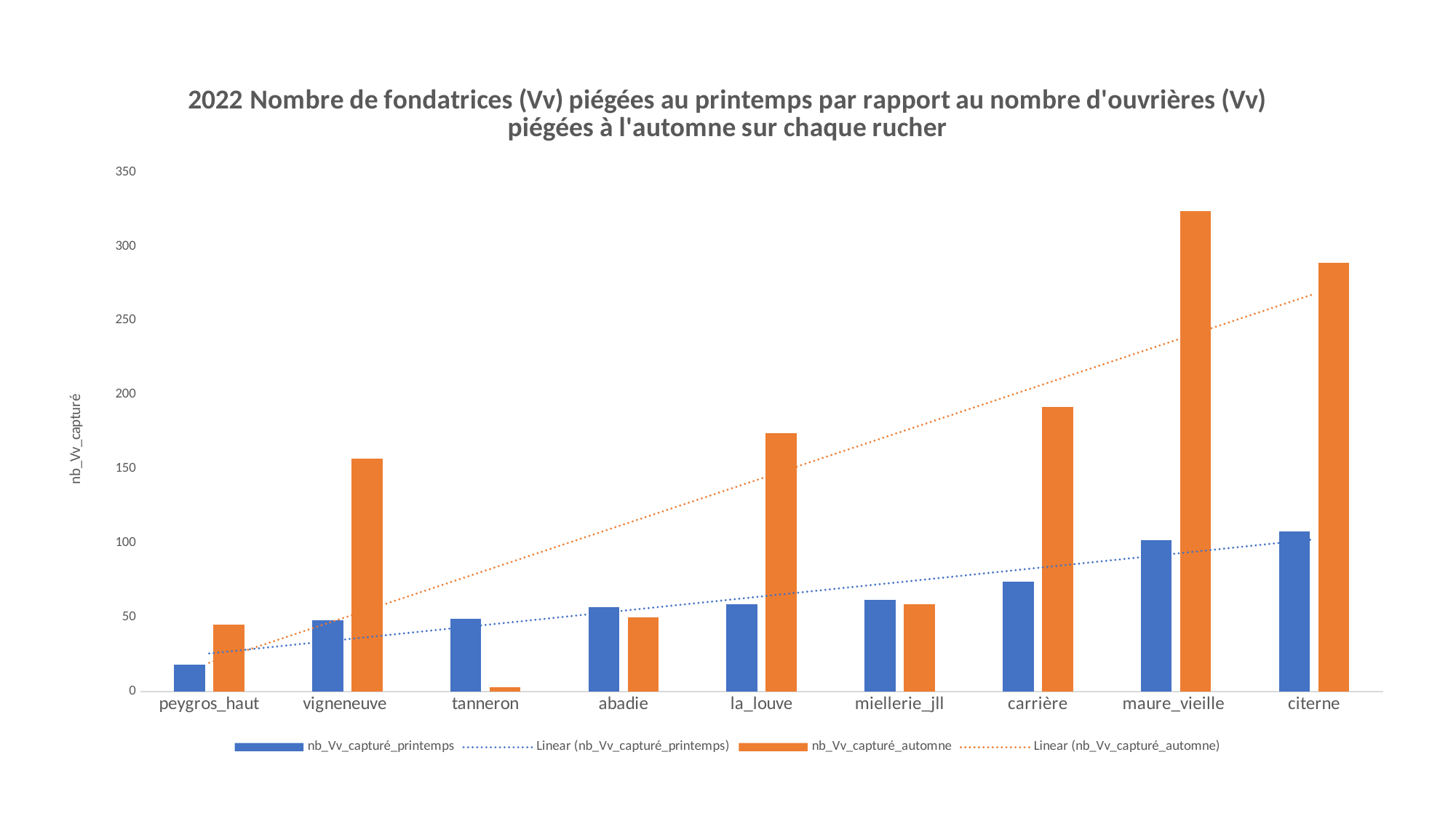
Which rucher has the lowest nb_Vv_capturé_printemps value? peygros_haut What kind of chart is shown on the slide? bar chart How many entries does the legend list? 4 Which rucher has the lowest nb_Vv_capturé_automne value? tanneron Is the nb_Vv_capturé_printemps value for peygros_haut greater or less than 50? less Do the nb_Vv_capturé_printemps values generally rise or fall from left to right along the x axis? rise Which rucher has the highest nb_Vv_capturé_automne value? maure_vieille For la_louve, which is larger: nb_Vv_capturé_printemps or nb_Vv_capturé_automne? nb_Vv_capturé_automne How many ruchers (categories) are shown on the x axis? 9 Is the nb_Vv_capturé_automne value for vigneneuve greater or less than 150? greater For tanneron, which is larger: nb_Vv_capturé_printemps or nb_Vv_capturé_automne? nb_Vv_capturé_printemps Is the nb_Vv_capturé_automne value for maure_vieille greater or less than 300? greater